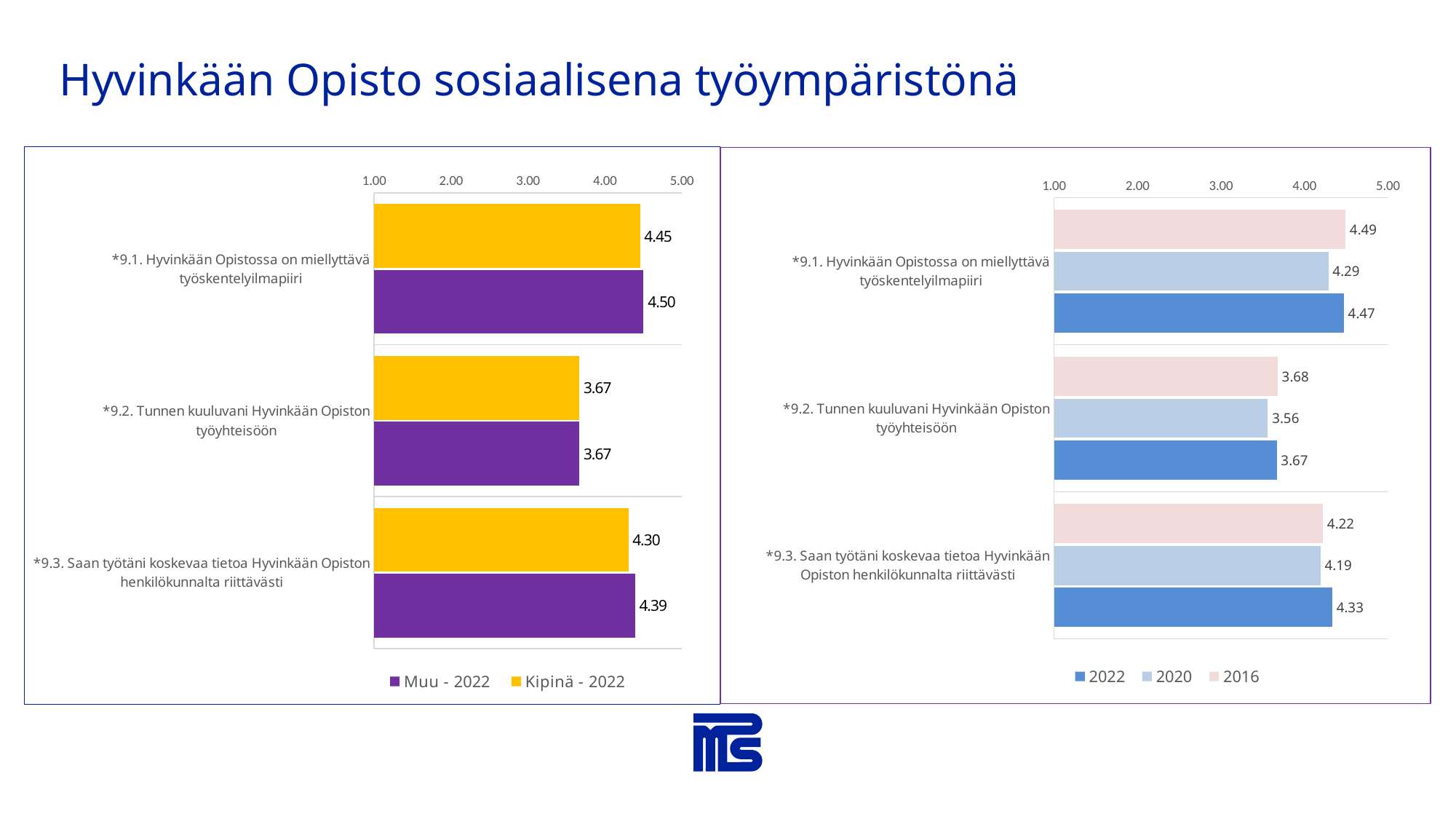
In the right chart, is the 2022 value for '*9.1. Hyvinkään Opistossa on miellyttävä työskentelyilmapiiri' larger or smaller than the 2020 value? Larger In the left chart, what is the value for Muu - 2022 for '*9.1. Hyvinkään Opistossa on miellyttävä työskentelyilmapiiri'? 4.50 In the right chart, what is the difference between the 2022 and 2020 values for '*9.3. Saan työtäni koskevaa tietoa Hyvinkään Opiston henkilökunnalta riittävästi'? 0.14 In the right chart, what is the 2020 value for '*9.2. Tunnen kuuluvani Hyvinkään Opiston työyhteisöön'? 3.56 In the left chart, which category has the lowest Kipinä - 2022 value? *9.2. Tunnen kuuluvani Hyvinkään Opiston työyhteisöön In the left chart, what is the value for Kipinä - 2022 for '*9.3. Saan työtäni koskevaa tietoa Hyvinkään Opiston henkilökunnalta riittävästi'? 4.30 In the right chart, which year has the highest value for '*9.3. Saan työtäni koskevaa tietoa Hyvinkään Opiston henkilökunnalta riittävästi'? 2022 What kind of chart is the left chart? Bar chart In the left chart, what is the difference between the Muu - 2022 and Kipinä - 2022 values for '*9.3. Saan työtäni koskevaa tietoa Hyvinkään Opiston henkilökunnalta riittävästi'? 0.09 How many series does the legend of the left chart list? 2 How many series does the legend of the right chart list? 3 In the right chart, what is the 2016 value for '*9.1. Hyvinkään Opistossa on miellyttävä työskentelyilmapiiri'? 4.49